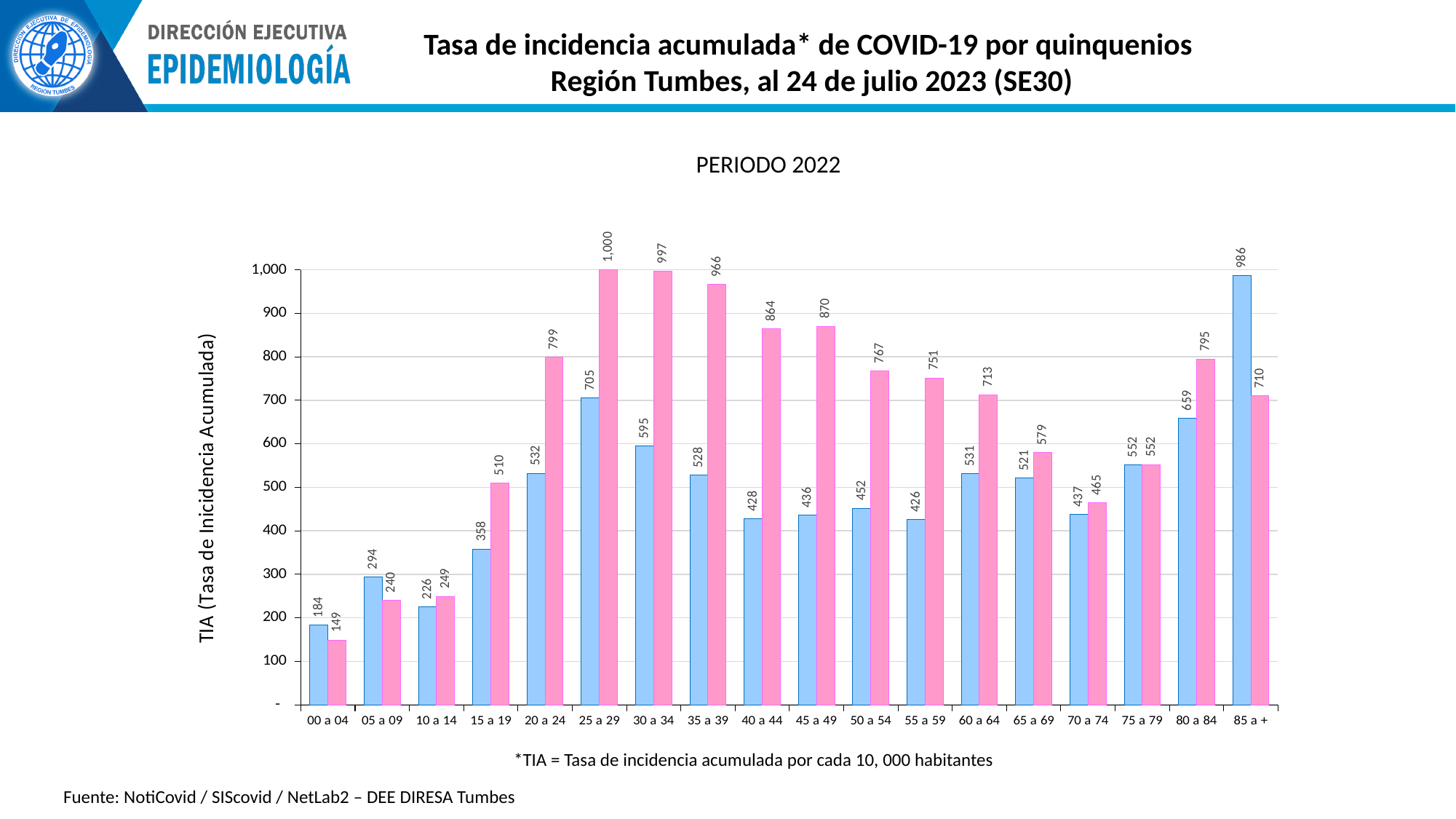
Is the value of the pink bar for 35 a 39 greater or less than 900? greater What is the title shown above the chart? PERIODO 2022 Which age group has the highest pink bar? 25 a 29 What kind of chart is shown on the slide? bar chart What is the value of the pink bar for the 40 a 44 age group? 864 What is the difference between the pink and blue bars for the 20 a 24 age group? 267 For the 05 a 09 age group, which bar is larger, the blue or the pink? blue Which age group has the lowest blue bar? 00 a 04 How many age groups are shown on the x axis? 18 What is the value of the blue bar for the 25 a 29 age group? 705 What is the value of the blue bar for the 85 a + age group? 986 Which age group has the lowest pink bar? 00 a 04